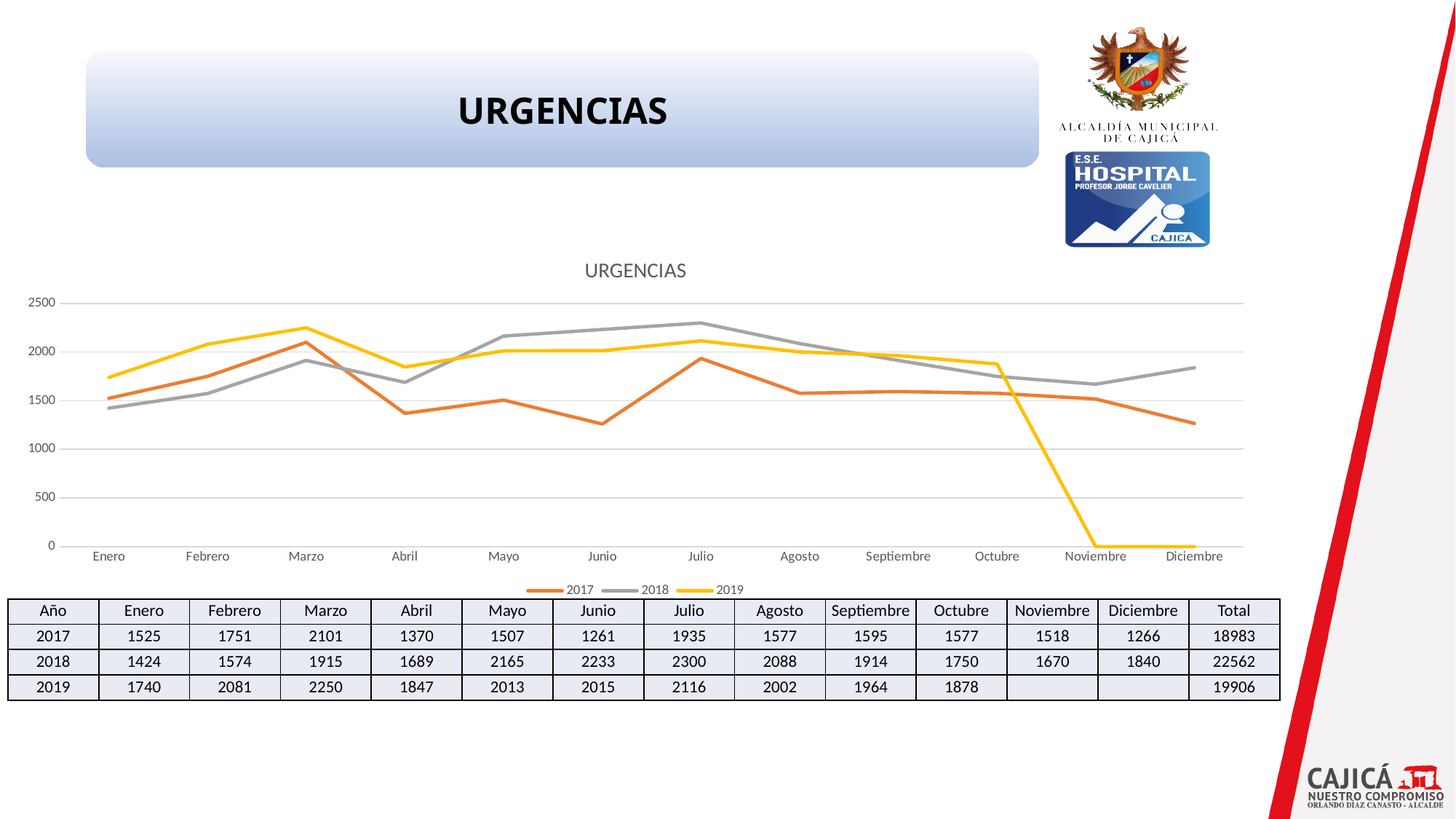
What kind of chart is shown on the slide? line chart Which series has the larger value in Mayo, 2018 or 2019? 2018 Does the 2019 series rise or fall from Julio to Octubre? fall How many series does the chart legend list? 3 What is the value for 2018 in Julio? 2300 How many months are plotted along the x axis of the chart? 12 What is the title of the chart? URGENCIAS Which month has the lowest value for the 2017 series? Junio What is the value for 2019 in Octubre? 1878 What is the difference between the 2019 and 2017 values in Marzo? 149 Is the value for 2017 in Abril greater or less than 1500? less Which month has the highest value for the 2018 series? Julio